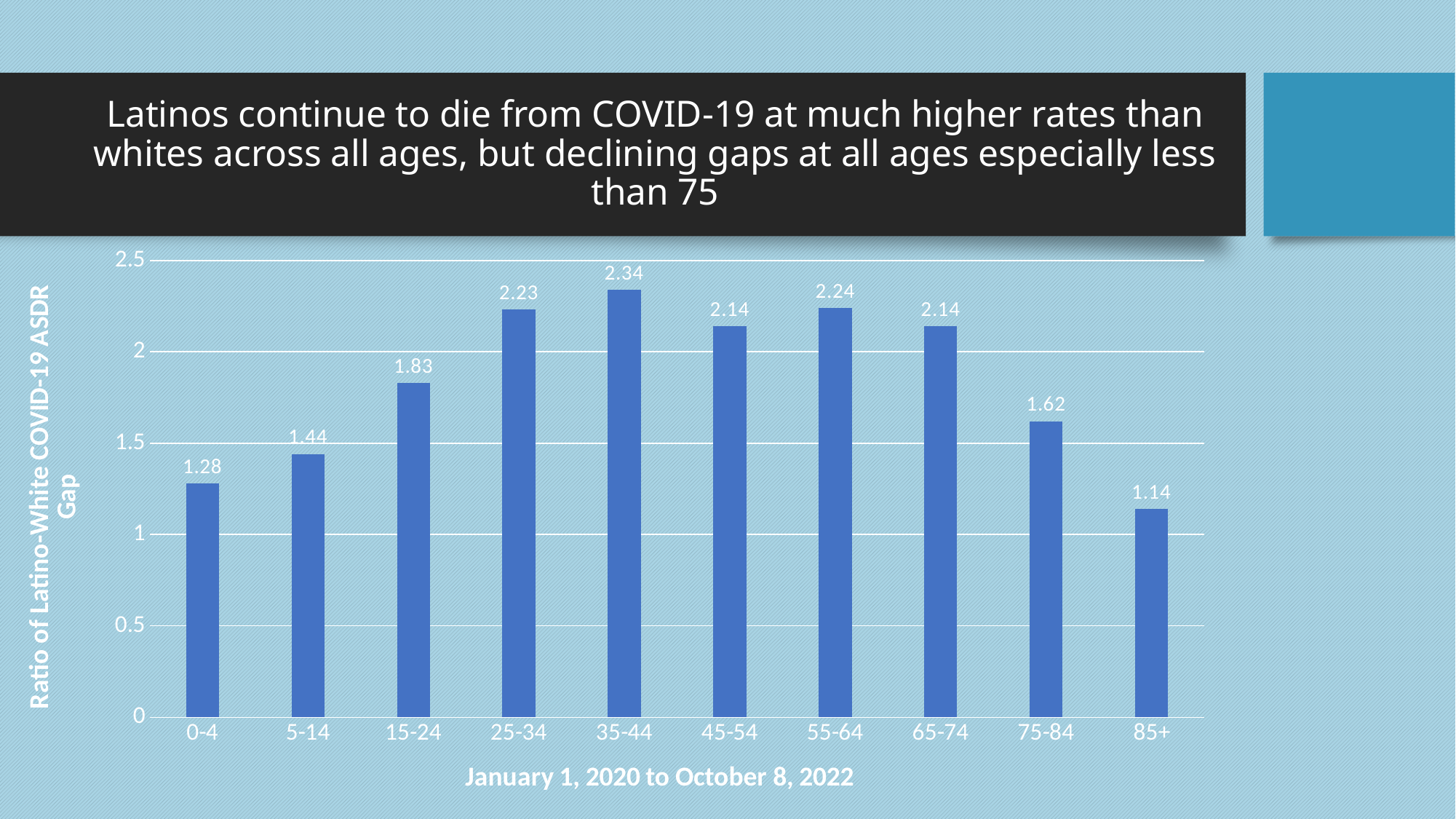
What is the difference between the values for the 35-44 and 85+ age groups? 1.20 What is the value shown for the 75-84 age group? 1.62 What is the difference between the values for the 25-34 and 15-24 age groups? 0.40 What kind of chart is shown on the slide? bar chart How many age groups are shown on the x axis? 10 What is the value shown for the 0-4 age group? 1.28 What is the ratio of Latino-White COVID-19 ASDR gap for the 35-44 age group? 2.34 What is the x-axis title of the chart? January 1, 2020 to October 8, 2022 Is the value for the 5-14 age group greater or less than 1.5? less Which age group has the lowest ratio? 85+ Which is larger, the value for 55-64 or the value for 65-74? 55-64 Which age group has the highest ratio? 35-44